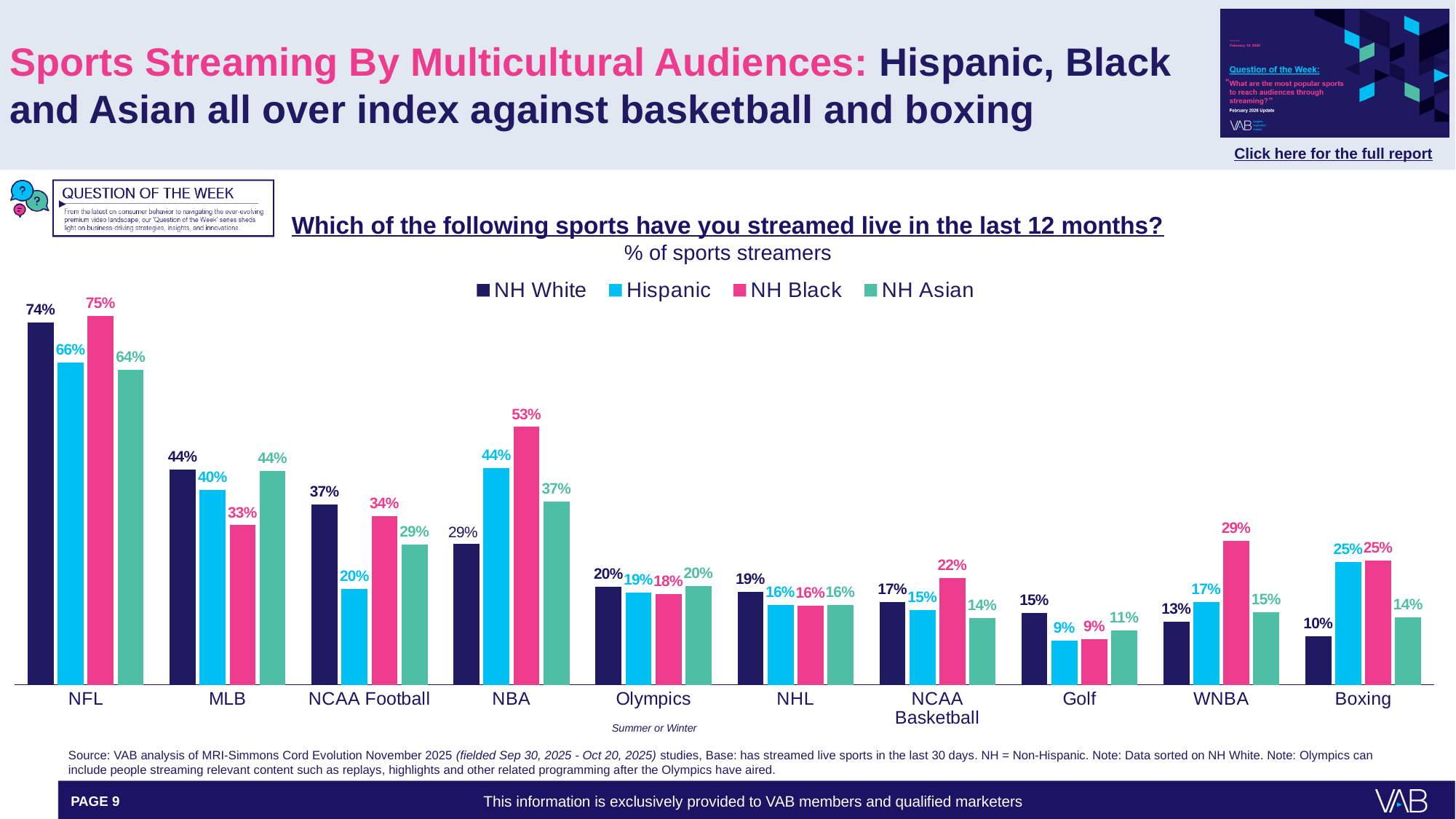
Which sport has the highest value for NH White streamers? NFL What percentage of NH Black sports streamers streamed the NBA live in the last 12 months? 53% What is the value for Hispanic streamers for the NFL? 66% How many sports categories are shown on the x axis? 10 Which series in the legend is shown in pink? NH Black Which sport has the lowest value for NH Black streamers? Golf What is the difference between the NH Black and NH White values for the WNBA? 16% For NCAA Football, which is larger: the NH White value or the Hispanic value? NH White How many series does the legend list? 4 What is the value for NH Asian streamers for Boxing? 14% Do the NH White values rise or fall moving from NFL to Boxing along the x axis? Fall What kind of chart is shown on the slide? Bar chart